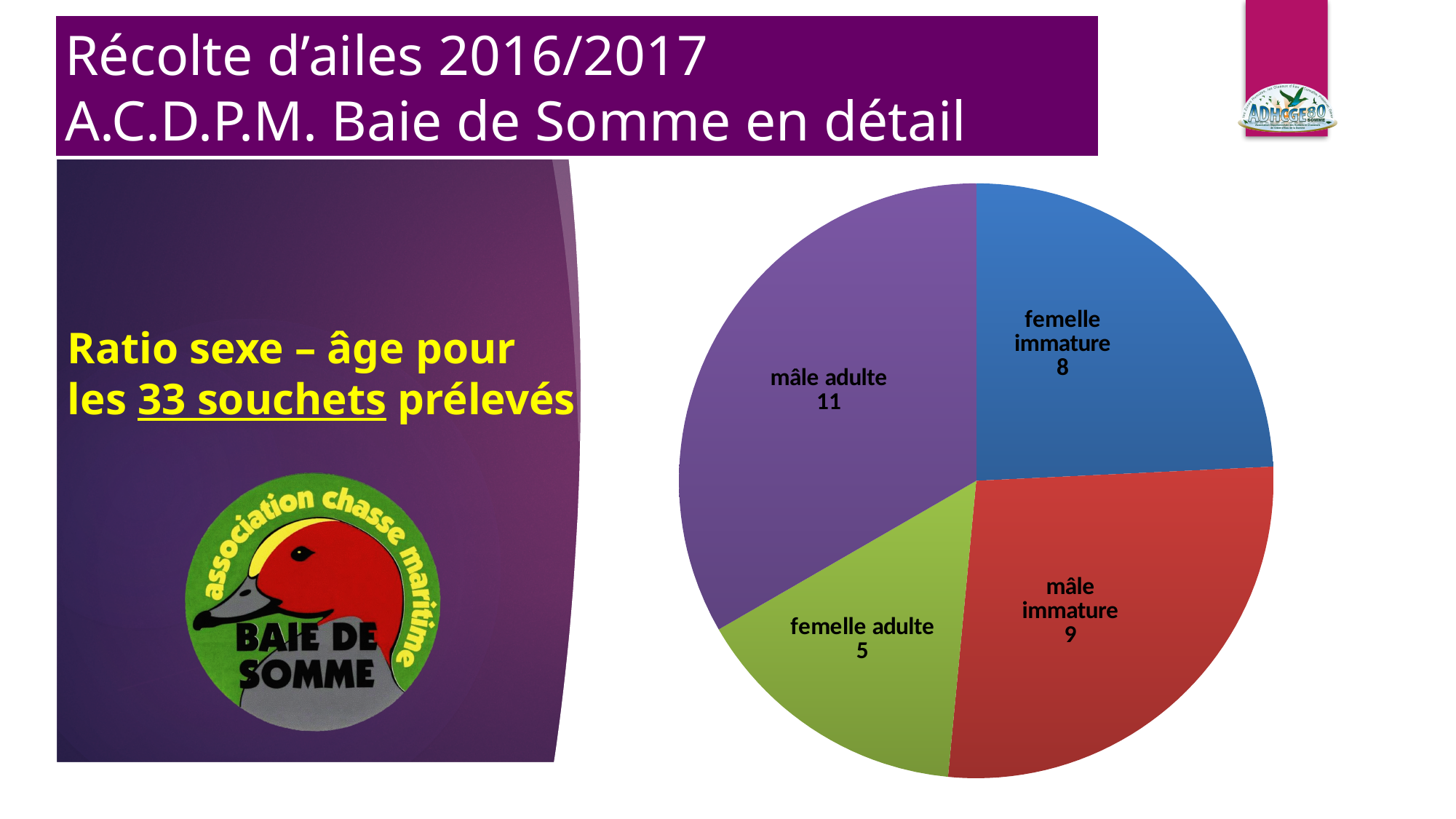
What is the value for mâle adulte? 11 What is the total of all slices in the pie chart? 33 What is the value for mâle immature? 9 Which category has the smallest slice? femelle adulte What colour is the mâle adulte slice? purple What is the difference between the values for mâle adulte and femelle adulte? 6 Which is larger, the value for mâle immature or femelle immature? mâle immature What is the value for femelle immature? 8 Which category has the largest slice? mâle adulte What is the value for femelle adulte? 5 How many slices does the pie chart have? 4 What kind of chart is shown on the slide? pie chart